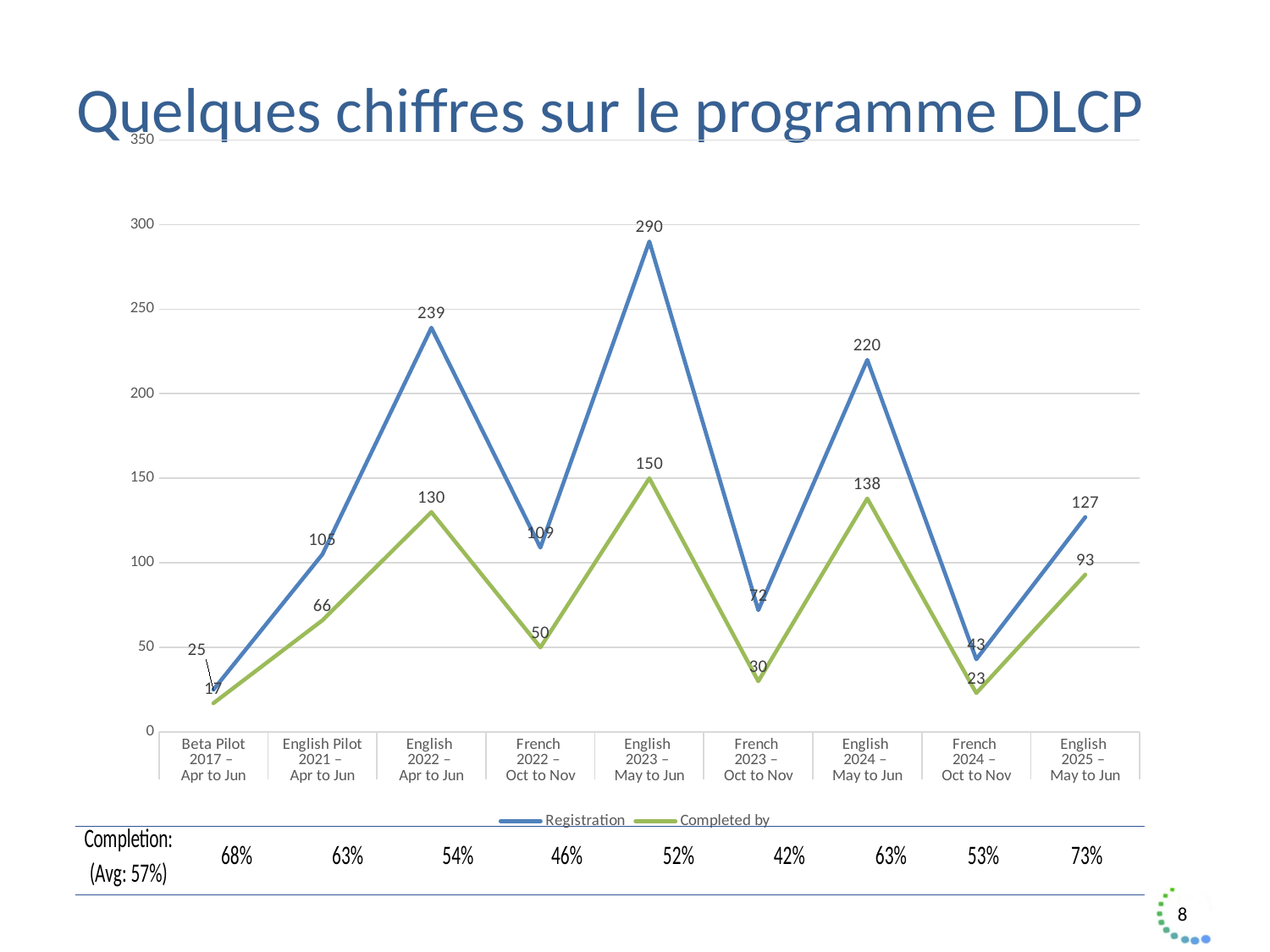
Which has the larger Registration value: French 2022 – Oct to Nov or French 2023 – Oct to Nov? French 2022 – Oct to Nov Which category has the lowest Completed by value? Beta Pilot 2017 – Apr to Jun What is the Completed by value for English 2025 – May to Jun? 93 What kind of chart is shown on the slide? line chart Which category has the highest Registration value? English 2023 – May to Jun Is the Registration value for English 2024 – May to Jun greater or less than 200? greater How many series does the chart legend list? 2 How many categories are shown on the x axis? 9 What is the difference between Registration and Completed by for English 2022 – Apr to Jun? 109 What is the Completed by value for English 2024 – May to Jun? 138 What is the Registration value for English 2023 – May to Jun? 290 What are the two series names listed in the legend? Registration and Completed by